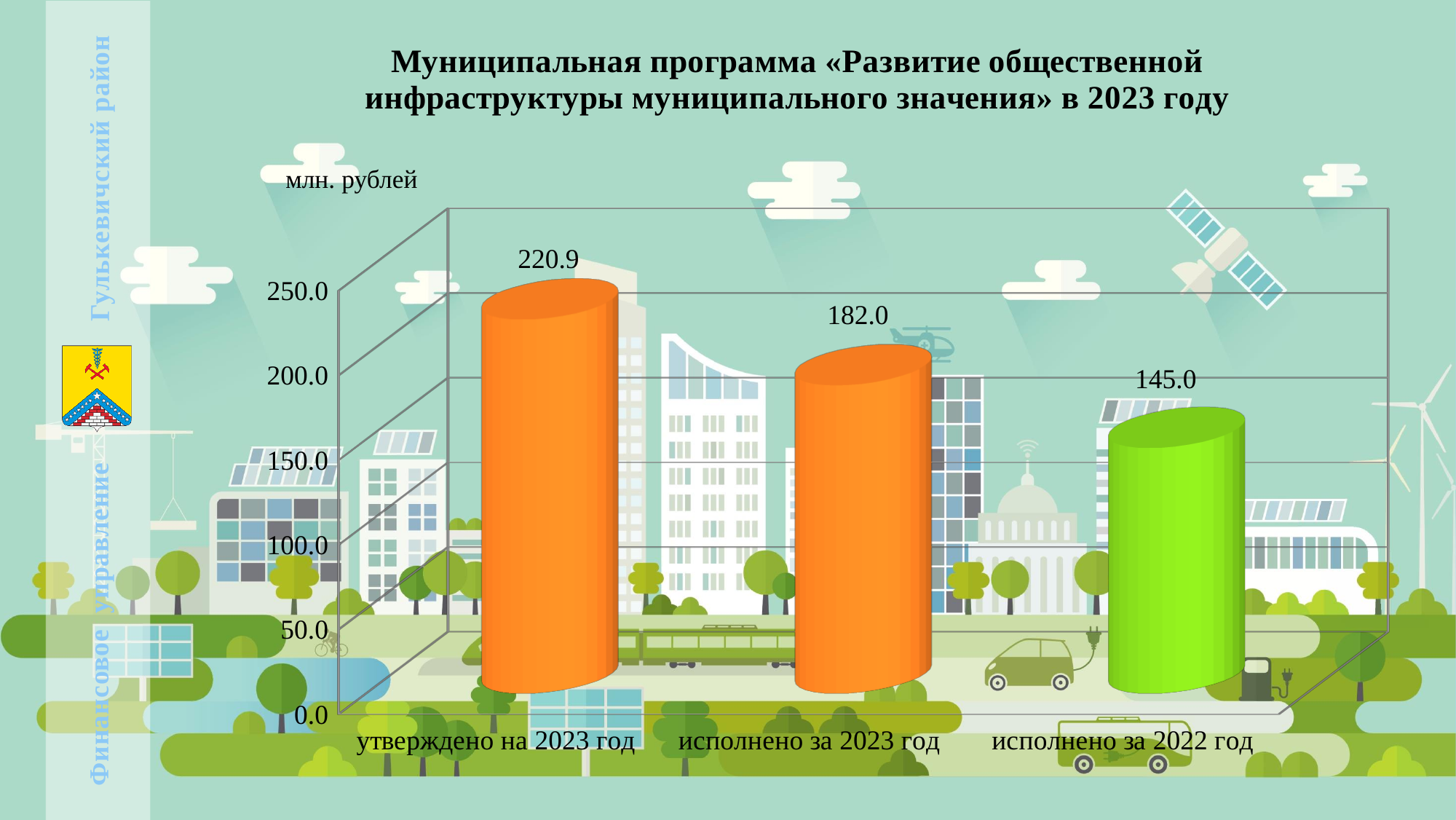
Which is larger: «исполнено за 2023 год» or «исполнено за 2022 год»? исполнено за 2023 год What unit of measurement is indicated on the chart? млн. рублей What is the value for «утверждено на 2023 год»? 220.9 What is the value for «исполнено за 2023 год»? 182.0 What is the difference between «утверждено на 2023 год» and «исполнено за 2023 год»? 38.9 How many categories are shown on the chart? 3 What is the difference between «исполнено за 2023 год» and «исполнено за 2022 год»? 37.0 Is the value for «исполнено за 2022 год» greater or less than 150.0? less What is the value for «исполнено за 2022 год»? 145.0 Which category has the lowest value? исполнено за 2022 год What kind of chart is shown on the slide? bar chart Which category has the highest value? утверждено на 2023 год